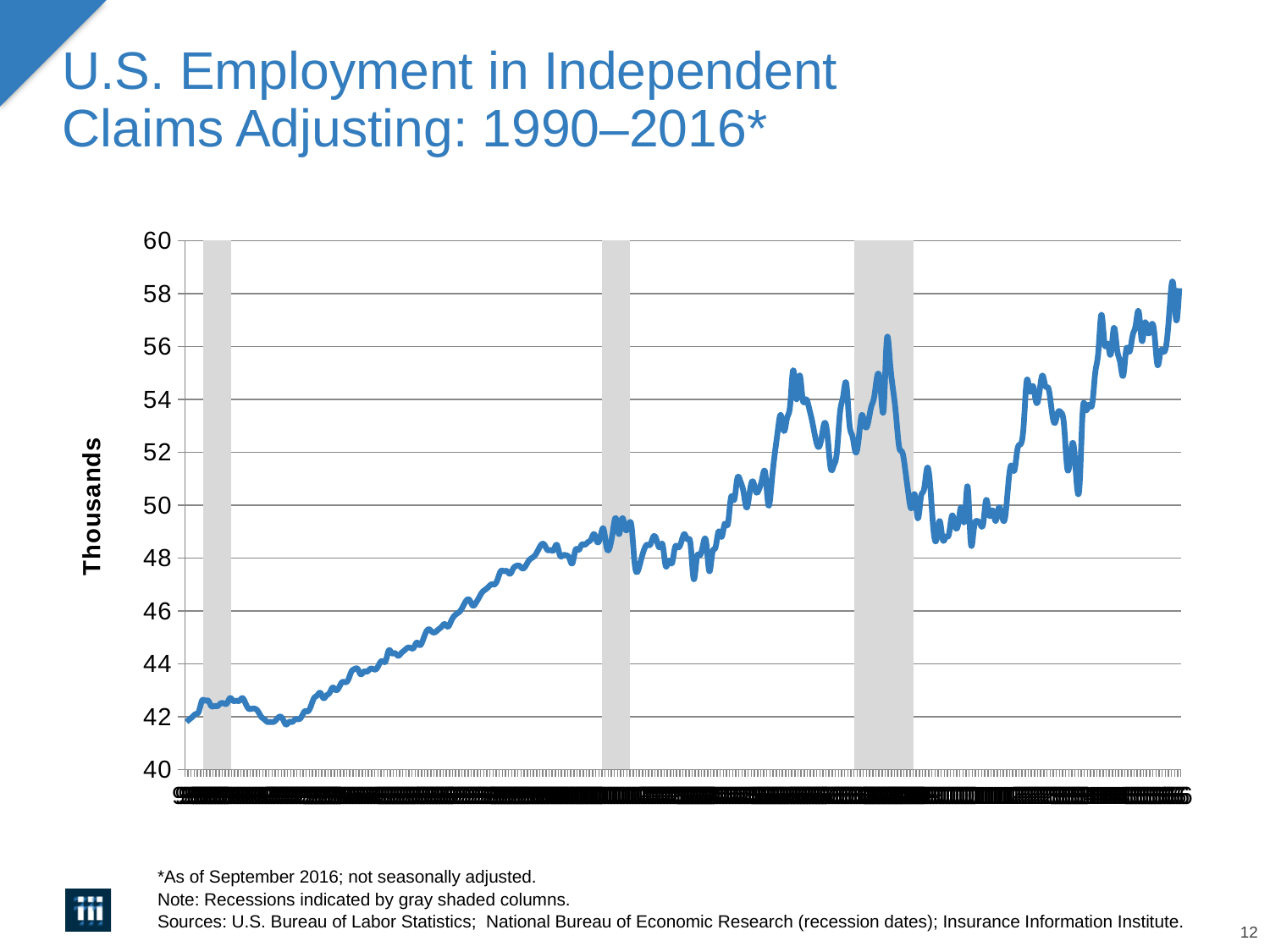
Is the value at the end of the series greater or less than 56? greater Is the value at the start of the series greater or less than 44? less Is the value at the end of the series greater or less than 60? less What is the highest value shown on the vertical axis? 60 What is the label on the vertical axis? Thousands Overall, do the values rise or fall from the start of the series to the end? rise What is the title of the chart? U.S. Employment in Independent Claims Adjusting: 1990–2016* What kind of chart is shown on the slide? line chart Is the value at the end of the series greater or less than the value at the start of the series? greater